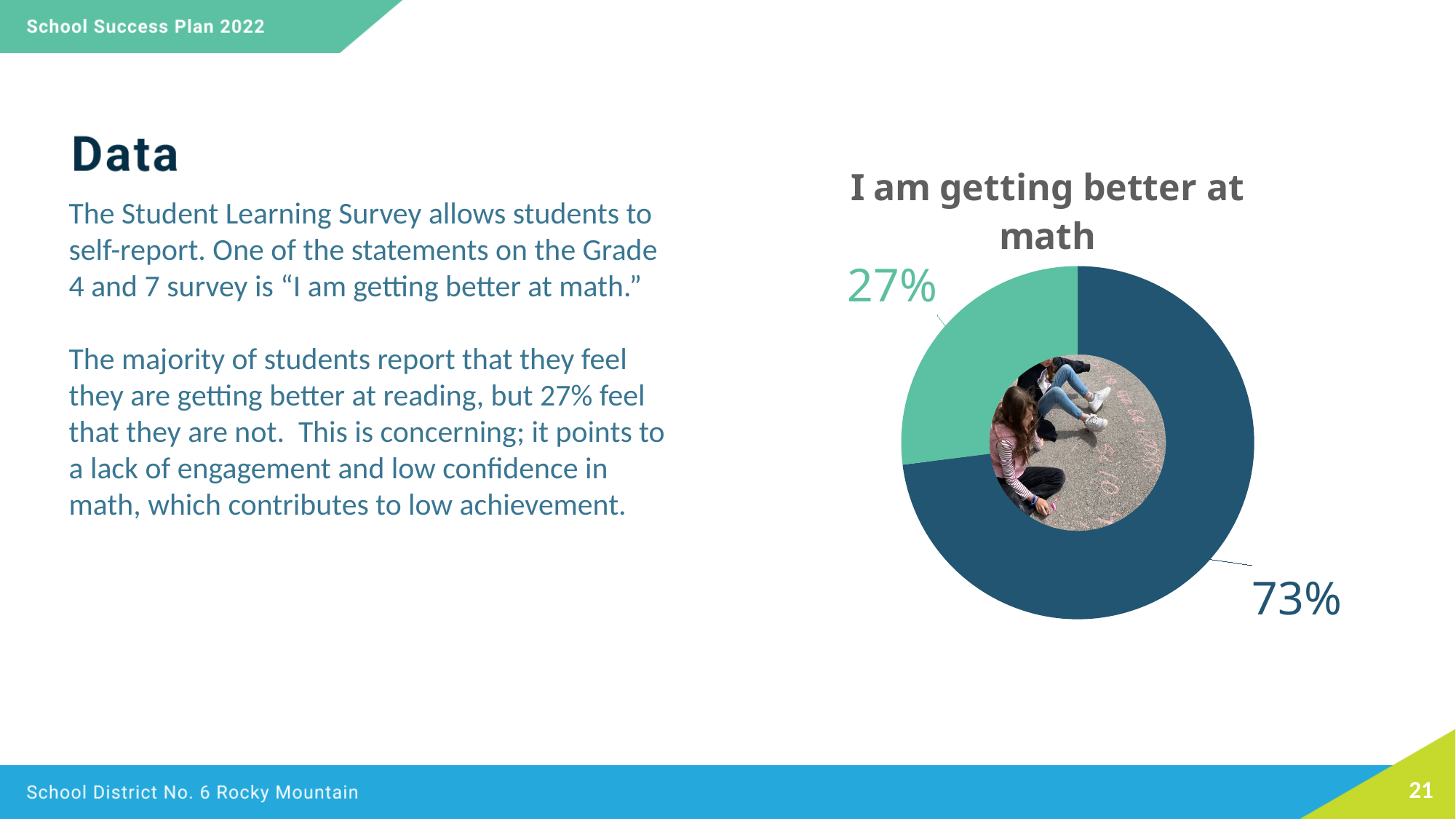
What is the smallest value shown on the pie chart? 27% What is the difference between the two slices of the pie chart? 46% Which slice of the pie chart is larger, the green one or the dark blue one? the dark blue one What share of the pie does the green slice represent? 27% What type of chart is shown on the slide? doughnut chart What is the title of the pie chart? I am getting better at math What is the largest value shown on the pie chart? 73% What do the two slices of the pie chart add up to? 100% How many slices does the pie chart have? 2 What percentage is shown for the green slice of the pie chart? 27% What percentage is shown for the dark blue slice of the pie chart? 73% What colour is the slice labelled 73% in the pie chart? dark blue